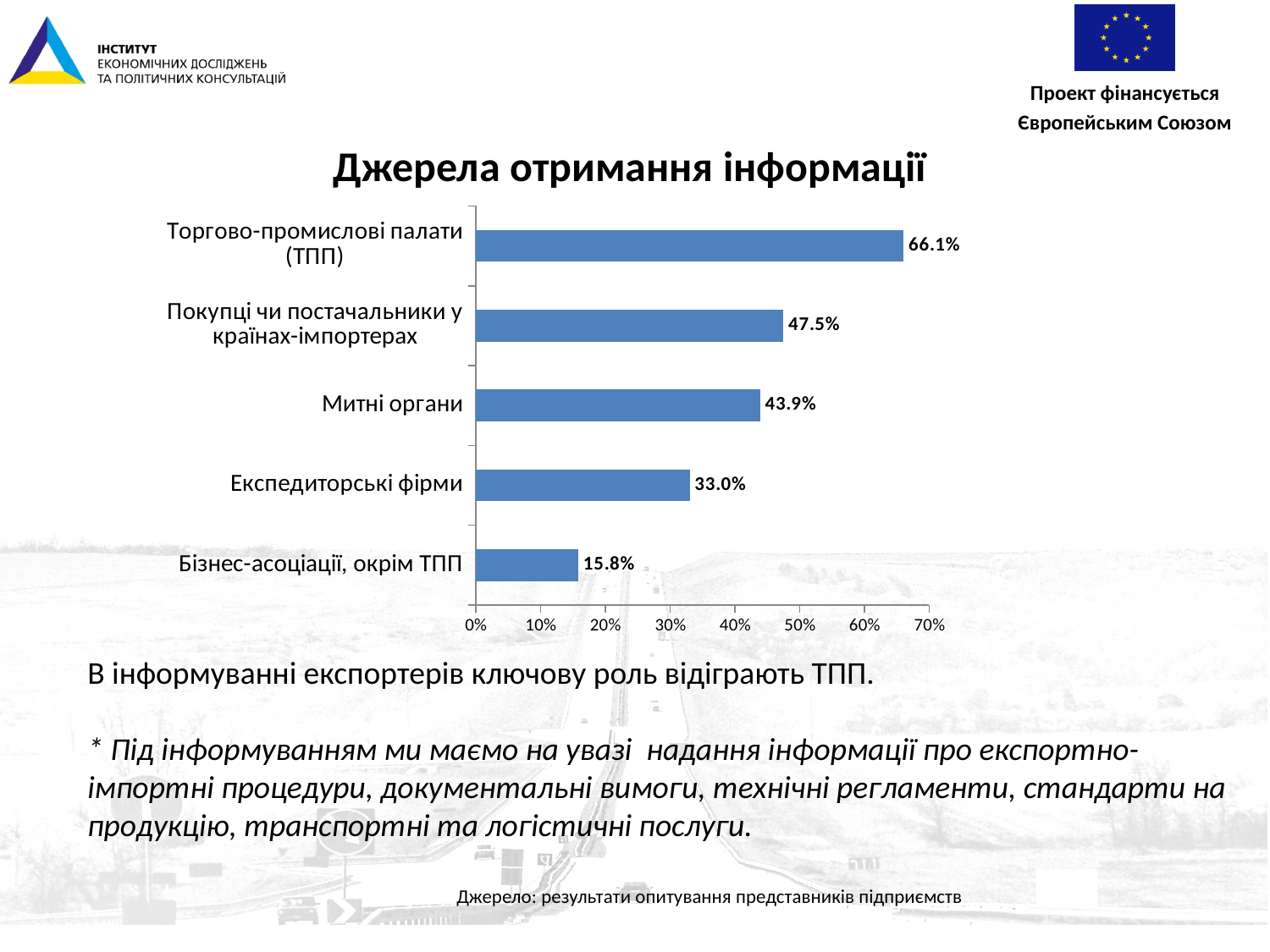
What is the value for Митні органи? 43.9% Which category has the highest value? Торгово-промислові палати (ТПП) What is the difference between the values for Покупці чи постачальники у країнах-імпортерах and Митні органи? 3.6% What kind of chart is shown on the slide? bar chart What is the title of the chart? Джерела отримання інформації What is the value for Експедиторські фірми? 33.0% Is the value for Покупці чи постачальники у країнах-імпортерах greater or less than 40%? greater What is the value for Бізнес-асоціації, окрім ТПП? 15.8% What is the value for Торгово-промислові палати (ТПП)? 66.1% Which category has the lowest value? Бізнес-асоціації, окрім ТПП Which is larger: the value for Експедиторські фірми or the value for Митні органи? Митні органи How many categories are shown in the chart? 5